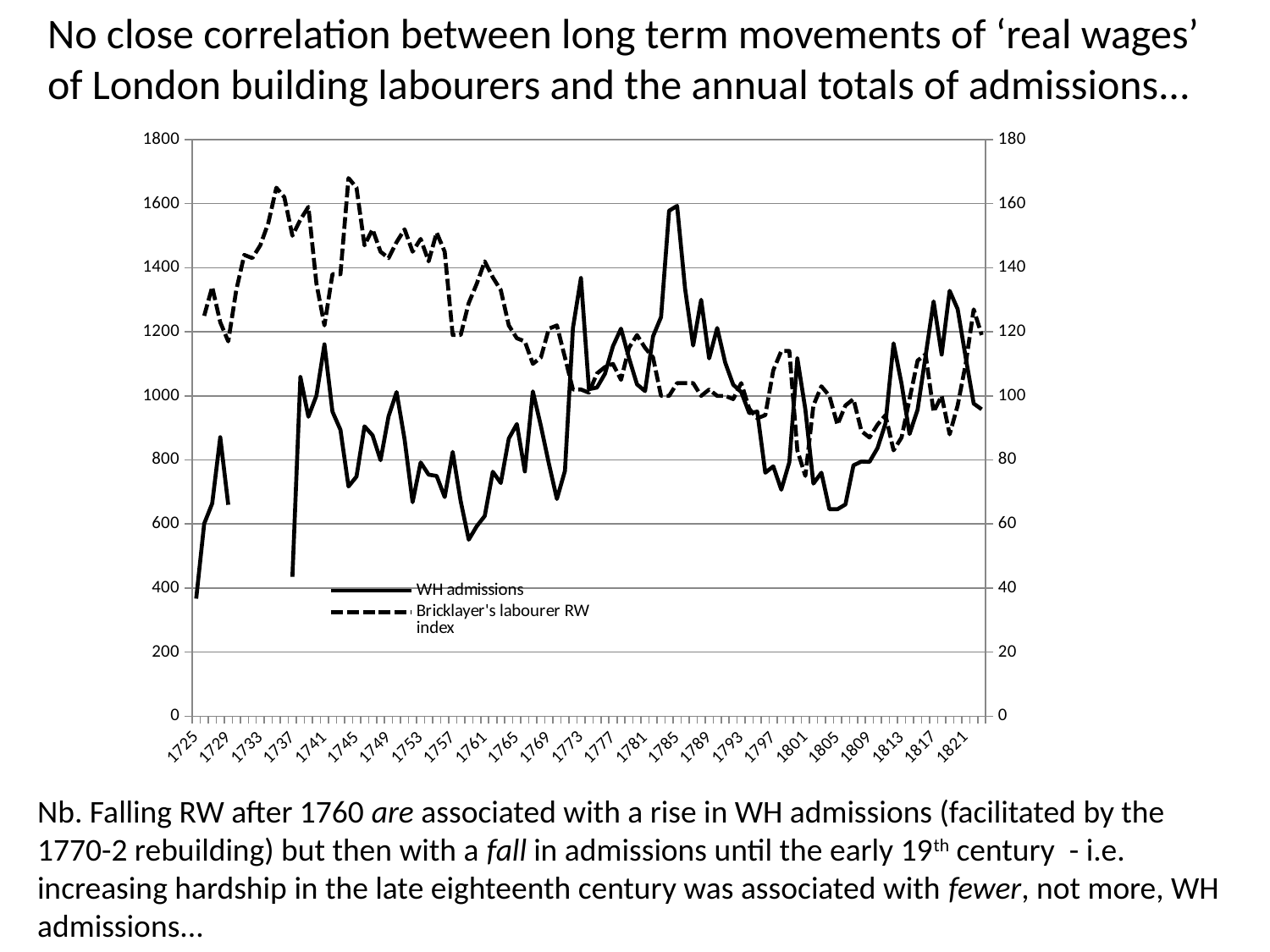
Which series is drawn with a solid line? WH admissions Is the value for WH admissions around 1773 greater or less than 1200 on the left axis? greater What kind of chart is shown on the slide? line chart Is the value for the Bricklayer's labourer RW index around 1805 greater or less than 120 on the right axis? less Does the Bricklayer's labourer RW index generally rise or fall between 1745 and 1805? fall Is the value for WH admissions at 1725 greater or less than 600 on the left axis? less Do WH admissions generally rise or fall between 1785 and 1805? fall How many series does the chart's legend list? 2 Which series is drawn with a dashed line? Bricklayer's labourer RW index